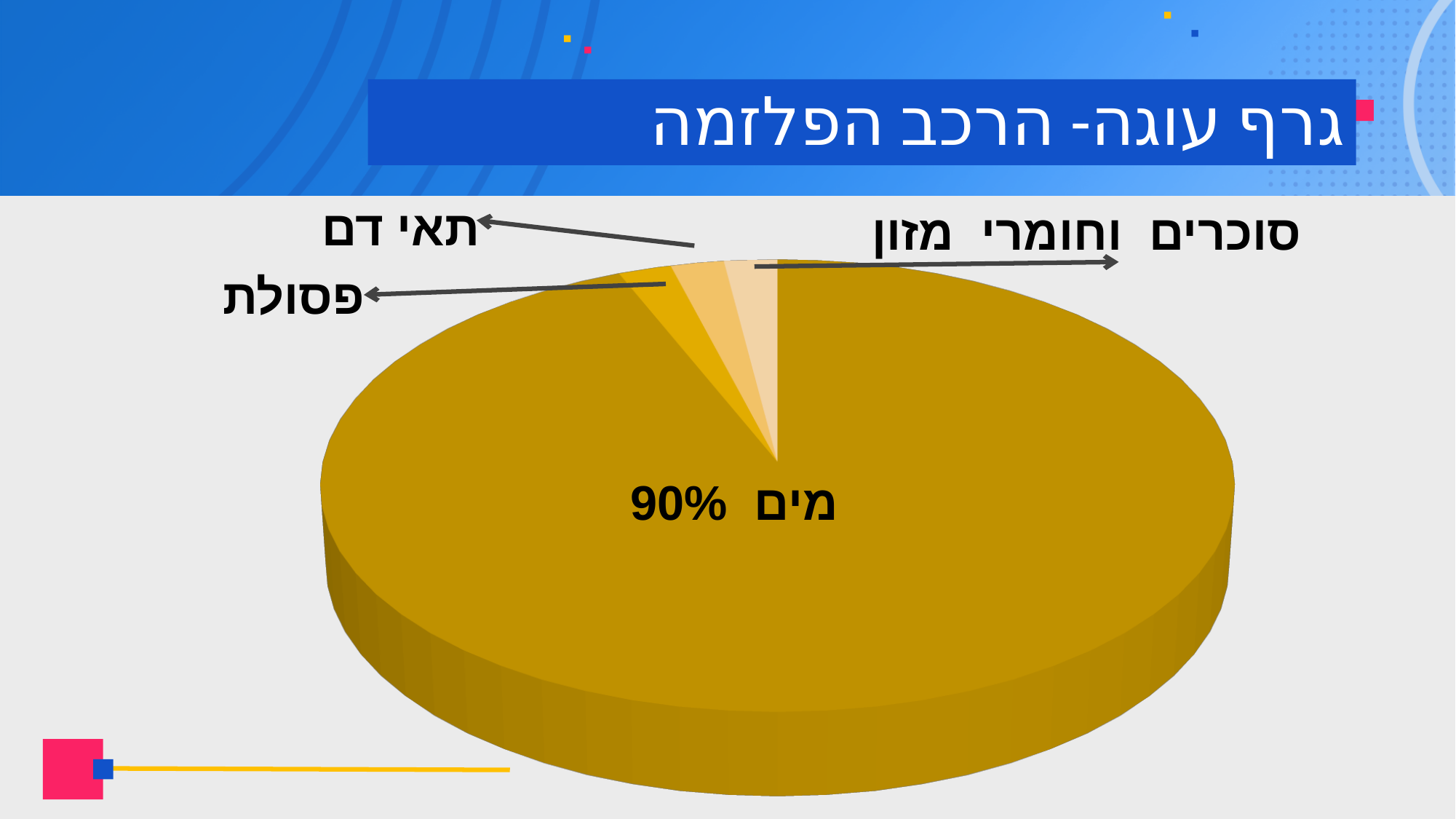
Which is larger, the slice for מים or the slice for תאי דם? מים What kind of chart is shown on the slide? pie chart What is the title of the chart on the slide? גרף עוגה- הרכב הפלזמה Which slice of the pie chart is the largest? מים Which slice label is pointed to by the arrow at the top right of the chart? סוכרים וחומרי מזון What percentage of the pie is labelled for מים (water)? 90% How many slices does the pie chart have? 4 Which is larger, the slice for מים or the slice for פסולת? מים What share of the pie does the מים slice take up? 90%